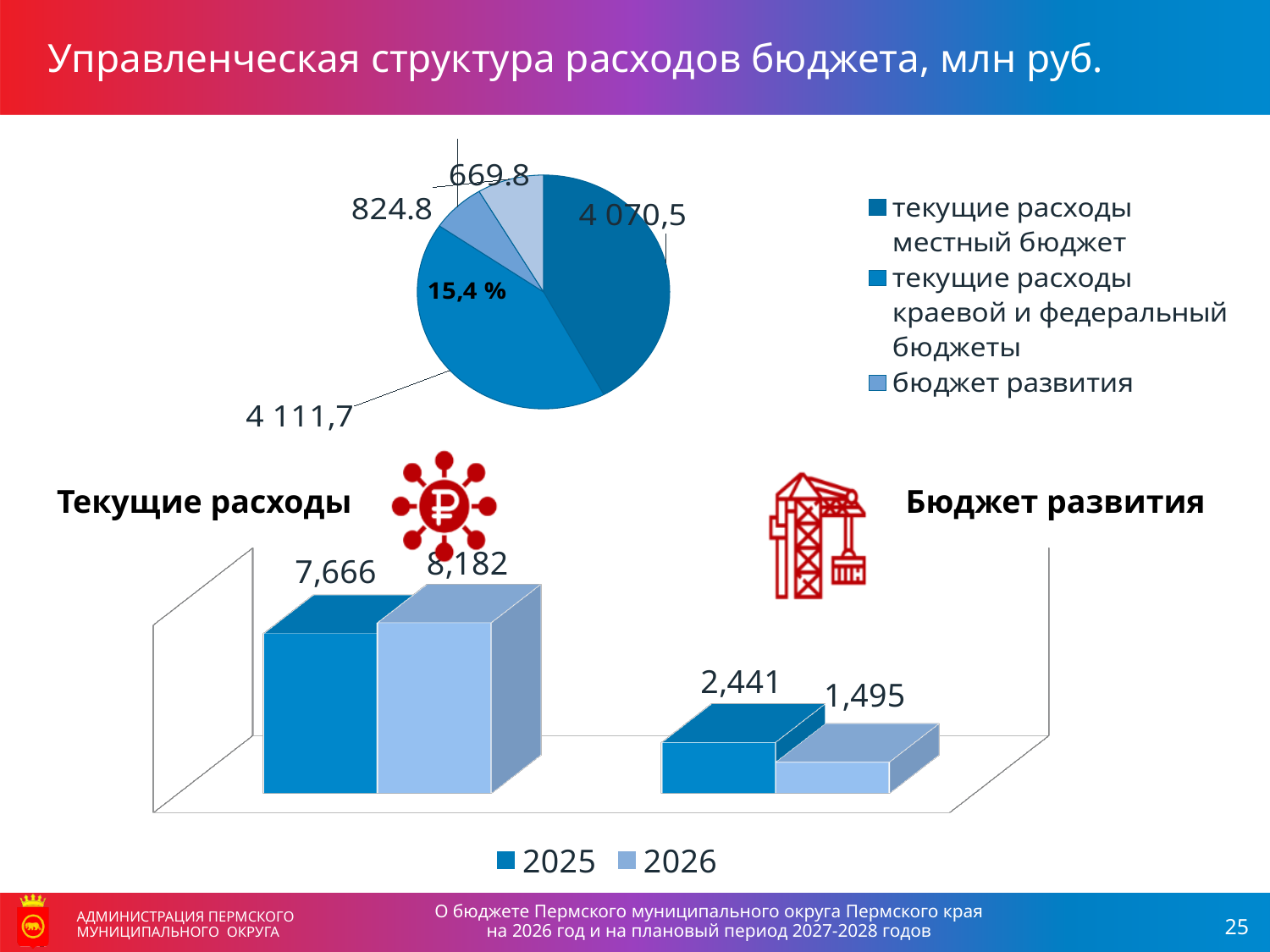
How many entries does the legend of the pie chart list? 3 In the bar chart at the bottom, by how much does Текущие расходы in 2026 exceed Текущие расходы in 2025? 516 In the pie chart, what percentage label is printed inside the pie? 15,4 % In the bar chart at the bottom, what is the value for Бюджет развития in 2025? 2,441 In the bar chart at the bottom, what is the value for Бюджет развития in 2026? 1,495 In the bar chart at the bottom, does the value for Бюджет развития rise or fall from 2025 to 2026? fall In the bar chart at the bottom, which year has the larger value for Бюджет развития, 2025 or 2026? 2025 In the bar chart at the bottom, what is the value for Текущие расходы in 2026? 8,182 What kind of chart is shown at the bottom of the slide? bar chart In the bar chart at the bottom, what is the value for Текущие расходы in 2025? 7,666 In the bar chart at the bottom, what is the difference between Бюджет развития in 2025 and in 2026? 946 How many series does the legend of the bar chart at the bottom list? 2